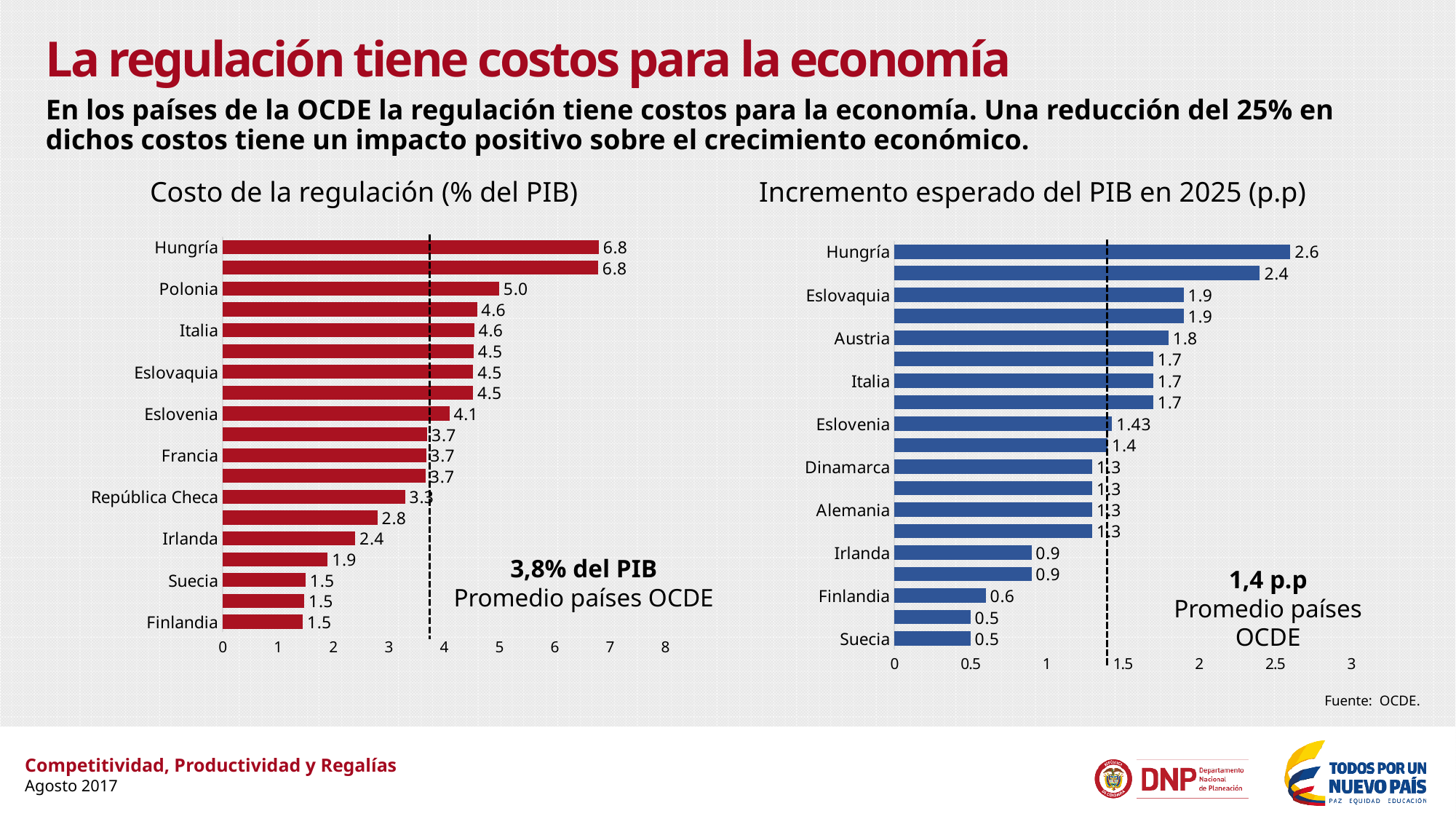
In the chart 'Costo de la regulación (% del PIB)', what is the value for República Checa? 3.3 In the chart 'Costo de la regulación (% del PIB)', what is the value for Hungría? 6.8 In the chart 'Incremento esperado del PIB en 2025 (p.p)', which country has the highest value? Hungría In the chart 'Incremento esperado del PIB en 2025 (p.p)', what is the value for Austria? 1.8 In the chart 'Costo de la regulación (% del PIB)', what is the value for Polonia? 5.0 In the chart 'Costo de la regulación (% del PIB)', what is the OECD average (Promedio países OCDE) shown on the chart? 3,8% del PIB In the chart 'Incremento esperado del PIB en 2025 (p.p)', what is the value for Finlandia? 0.6 In the chart 'Costo de la regulación (% del PIB)', what is the difference between the values for Hungría and Polonia? 1.8 In the chart 'Incremento esperado del PIB en 2025 (p.p)', what is the difference between the values for Hungría and Eslovaquia? 0.7 In the chart 'Costo de la regulación (% del PIB)', which is larger, the value for Italia or the value for Irlanda? Italia In the chart 'Incremento esperado del PIB en 2025 (p.p)', what is the value for Hungría? 2.6 What kind of chart is 'Costo de la regulación (% del PIB)'? Bar chart